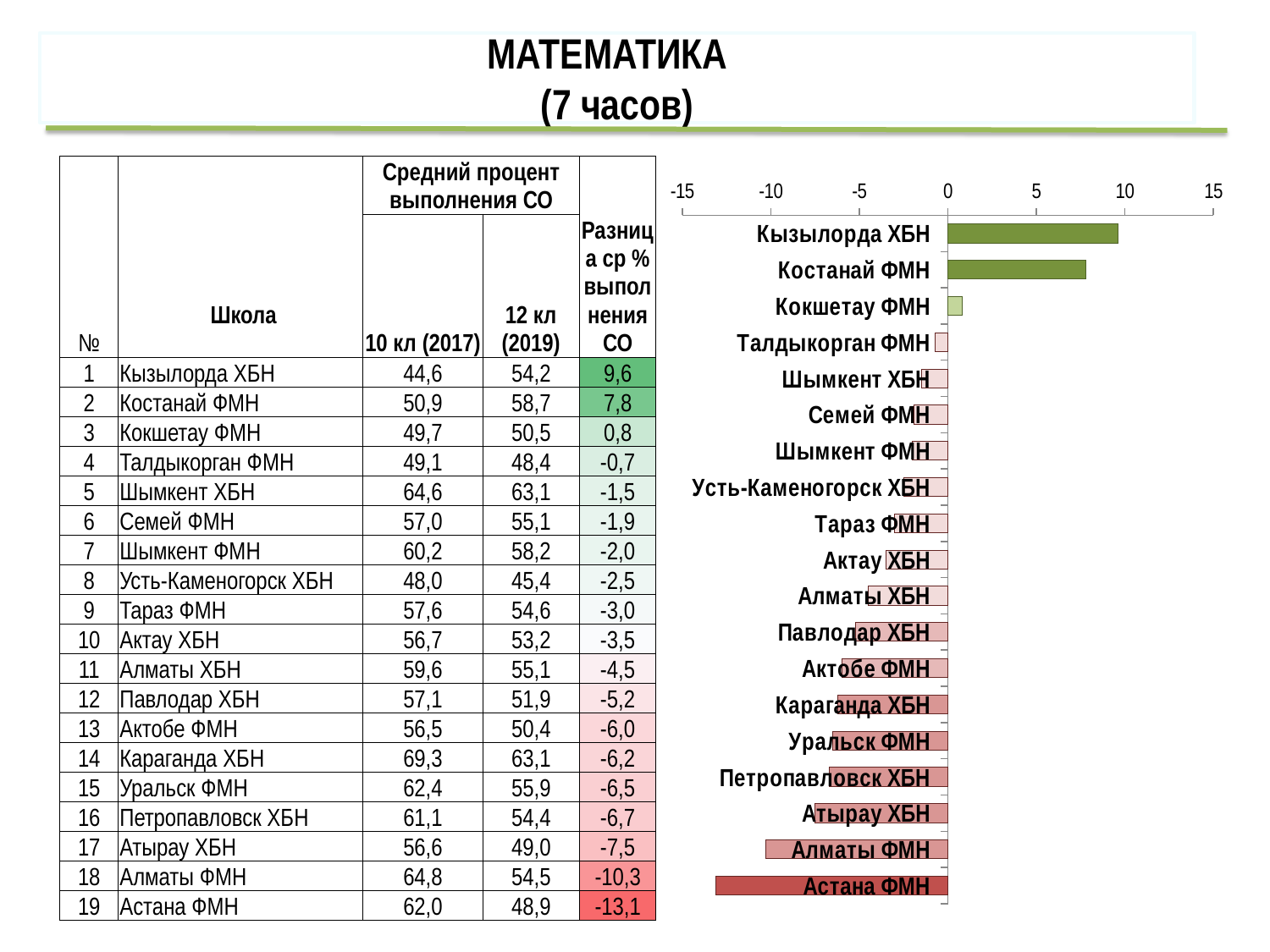
Going down the chart from Кызылорда ХБН to Астана ФМН, do the bar values rise or fall? fall What is the difference value (Разница ср % выполнения СО) plotted for Кызылорда ХБН? 9,6 By how much does the difference value for Кызылорда ХБН exceed that of Костанай ФМН? 1,8 Is the bar for Кызылорда ХБН greater or less than 5? greater Is the bar for Астана ФМН greater or less than -10? less What kind of chart is shown on the slide? bar chart What is the difference value (Разница ср % выполнения СО) plotted for Астана ФМН? -13,1 Which school has the lowest value in the bar chart? Астана ФМН Which school has the highest value in the bar chart? Кызылорда ХБН How many schools have a positive bar (to the right of 0) in the chart? 3 How many schools are plotted in the bar chart? 19 Which bar is longer, Костанай ФМН or Кокшетау ФМН? Костанай ФМН